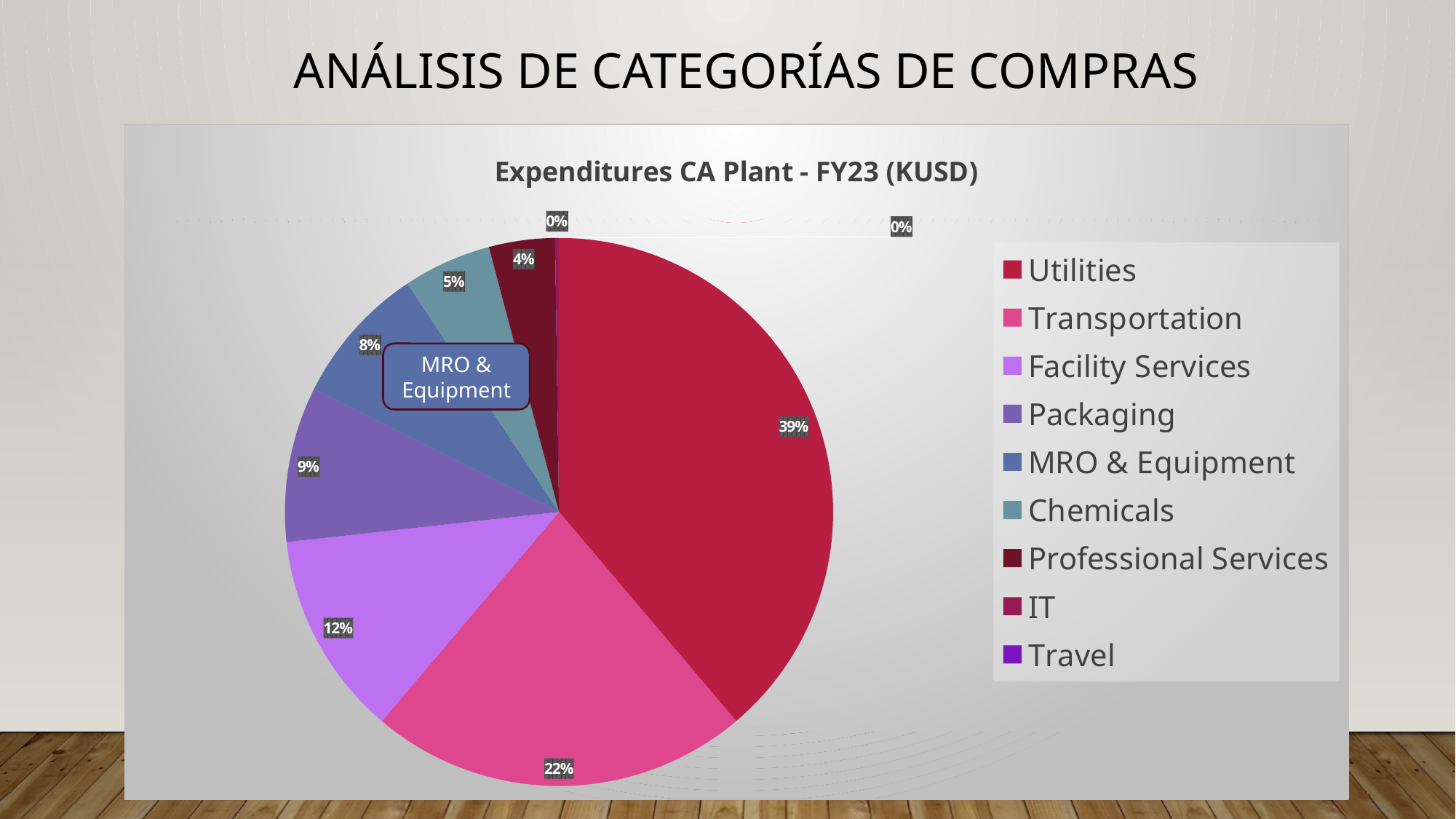
Which category has the largest share of expenditures? Utilities What share of expenditures does Utilities account for? 39% Which category has the smallest non-zero share of expenditures? Professional Services What percentage is shown for MRO & Equipment? 8% What percentage is shown for Transportation? 22% What type of chart is shown on the slide? Pie chart What percentage is shown for Facility Services? 12% How many categories does the legend list? 9 What is the difference in percentage points between Utilities and Transportation? 17 What is the title of the chart? Expenditures CA Plant - FY23 (KUSD) What percentage is shown for Chemicals? 5% Which has a larger share, Packaging or Chemicals? Packaging